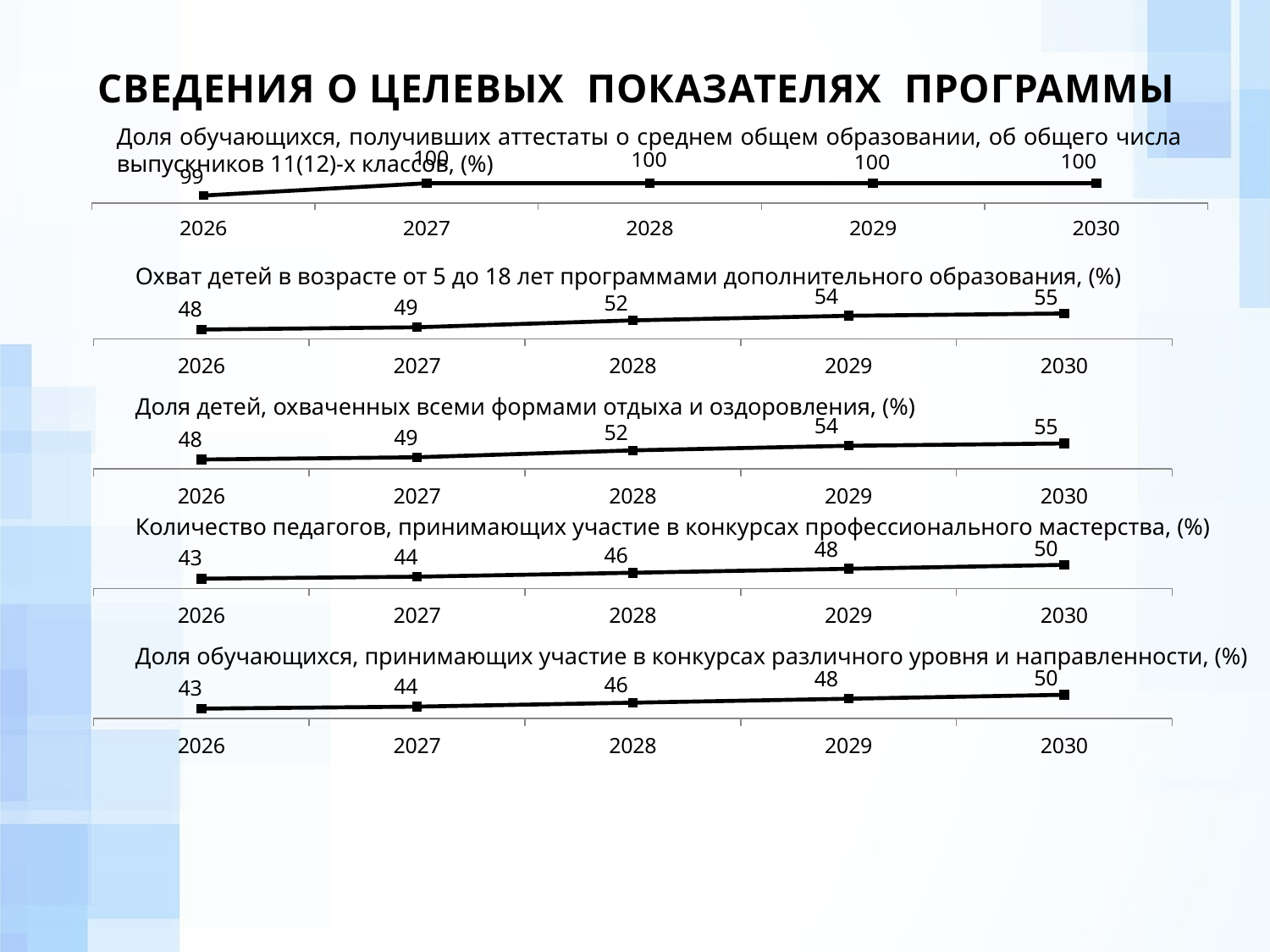
In the third chart from the top (Доля детей, охваченных всеми формами отдыха и оздоровления), what is the value for 2029? 54 In the second chart from the top (Охват детей в возрасте от 5 до 18 лет программами дополнительного образования), what is the value for 2028? 52 In the top chart (Доля обучающихся, получивших аттестаты о среднем общем образовании), what is the value for 2026? 99 In the second chart from the top (Охват детей в возрасте от 5 до 18 лет программами дополнительного образования), what is the difference between the 2030 and 2026 values? 7 In the third chart from the top (Доля детей, охваченных всеми формами отдыха и оздоровления), which year has the lowest value? 2026 How many data points are plotted in the bottom chart (Доля обучающихся, принимающих участие в конкурсах различного уровня и направленности)? 5 In the bottom chart (Доля обучающихся, принимающих участие в конкурсах различного уровня и направленности), what is the value for 2027? 44 In the bottom chart (Доля обучающихся, принимающих участие в конкурсах различного уровня и направленности), which is larger: the value for 2028 or the value for 2029? 2029 In the top chart (Доля обучающихся, получивших аттестаты о среднем общем образовании), what is the value for 2028? 100 In the fourth chart from the top (Количество педагогов, принимающих участие в конкурсах профессионального мастерства), do the values rise or fall from 2026 to 2030? rise In the second chart from the top (Охват детей в возрасте от 5 до 18 лет программами дополнительного образования), which year has the highest value? 2030 In the fourth chart from the top (Количество педагогов, принимающих участие в конкурсах профессионального мастерства), what is the value for 2030? 50